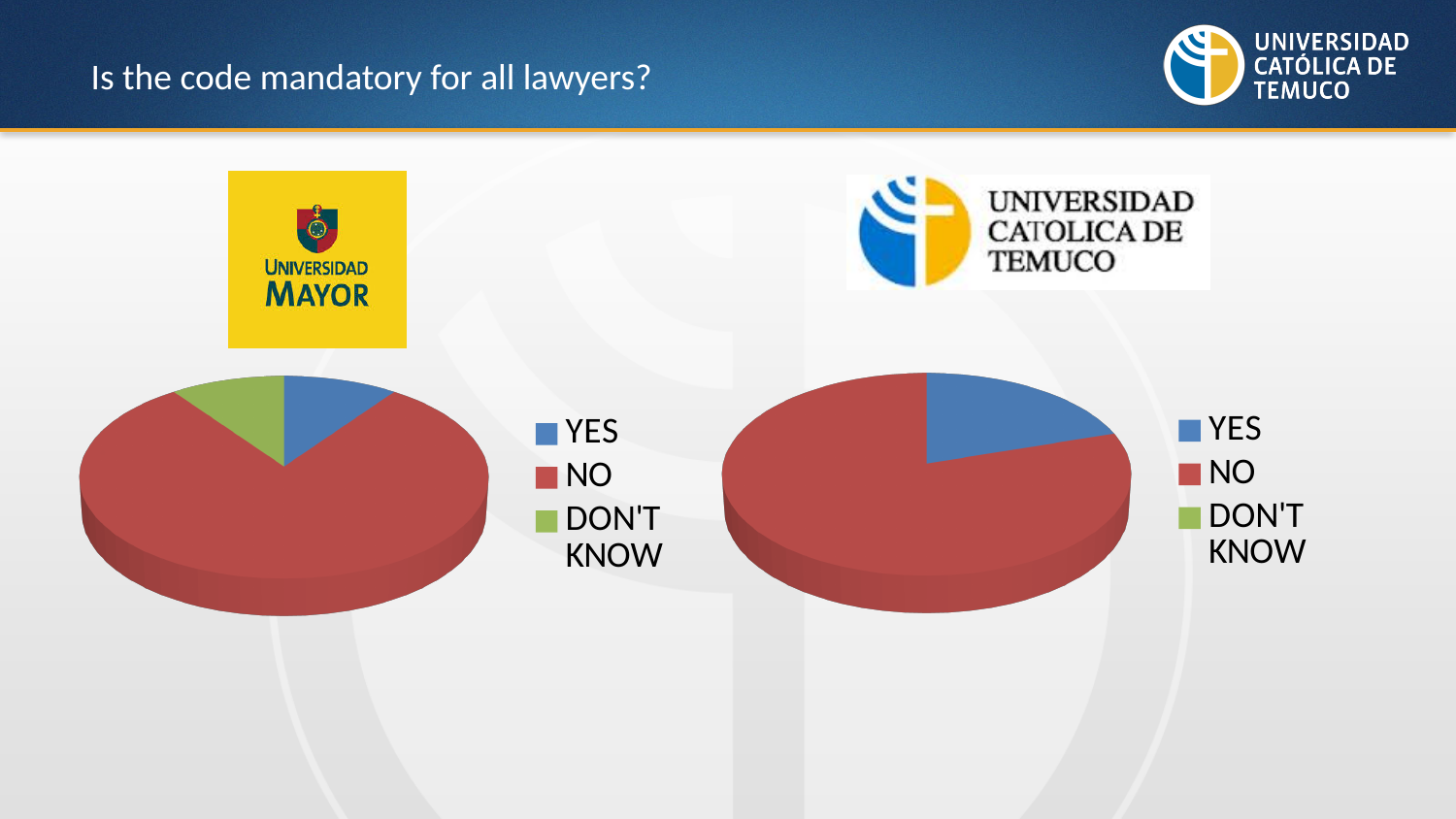
What kind of chart is the right chart (Universidad Católica de Temuco)? pie chart In the right chart (Universidad Católica de Temuco), which response has the largest slice? NO What question do the two pie charts on the slide answer? Is the code mandatory for all lawyers? How many slices are visible in the left chart (Universidad Mayor)? 3 What kind of chart is the left chart (Universidad Mayor)? pie chart In the left chart (Universidad Mayor), which is larger, the NO slice or the YES slice? NO How many entries does the legend of the left chart (Universidad Mayor) list? 3 How many entries does the legend of the right chart (Universidad Católica de Temuco) list? 3 What colour represents the NO response in both pie charts? red In the right chart (Universidad Católica de Temuco), which is larger, the YES slice or the NO slice? NO In the left chart (Universidad Mayor), which response has the largest slice? NO How many slices are visible in the right chart (Universidad Católica de Temuco)? 2